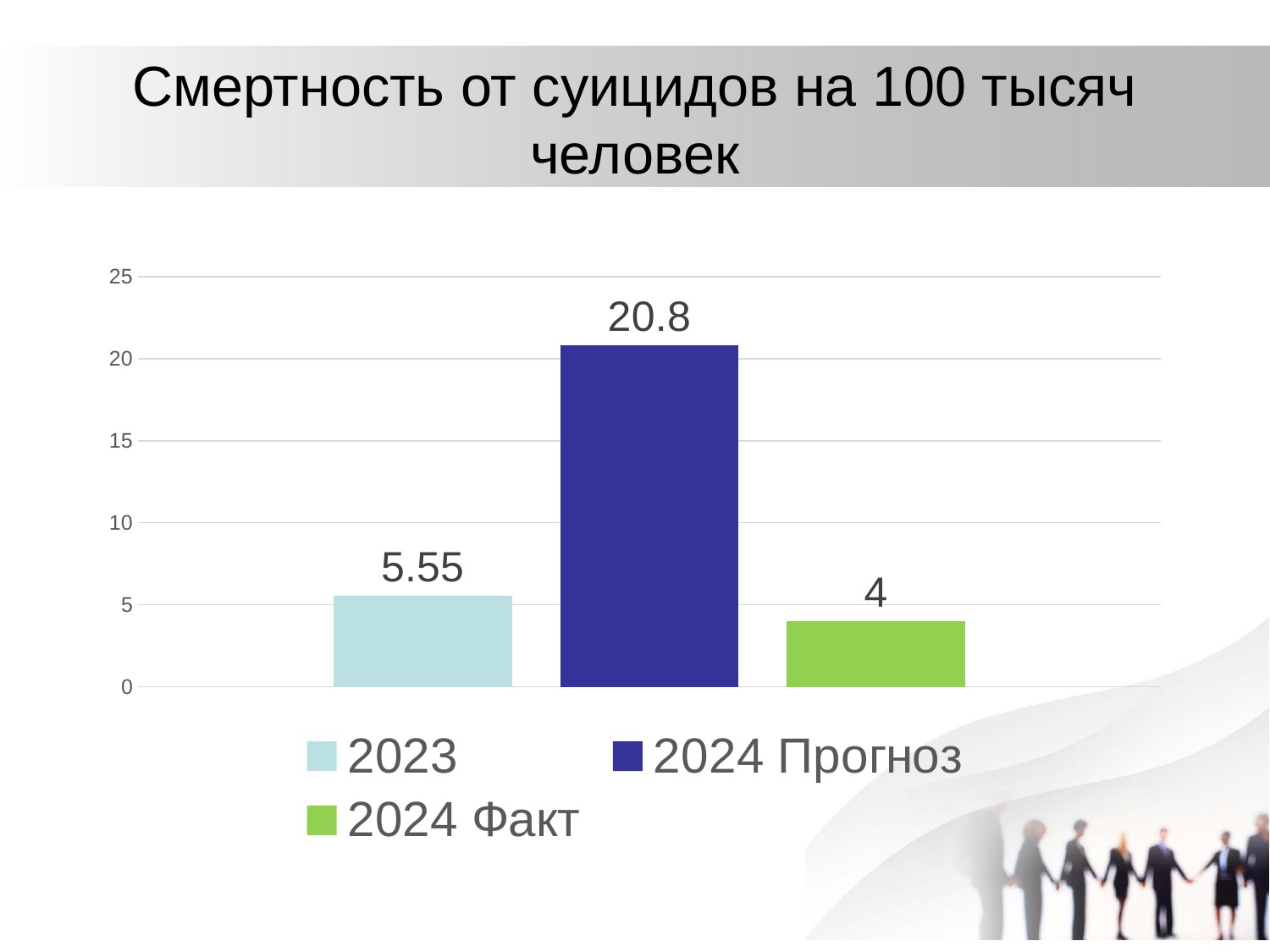
Which is larger, the value for 2023 or the value for 2024 Факт? 2023 Which series has the lowest value? 2024 Факт What kind of chart is shown on the slide? bar chart What is the title of the chart on the slide? Смертность от суицидов на 100 тысяч человек Is the value for 2024 Прогноз greater or less than 20? greater What is the value for 2024 Прогноз? 20.8 What is the difference between the 2024 Прогноз value and the 2024 Факт value? 16.8 What is the value for 2023? 5.55 What is the difference between the 2023 value and the 2024 Факт value? 1.55 What is the value for 2024 Факт? 4 Which series has the highest value? 2024 Прогноз How many series does the legend list? 3